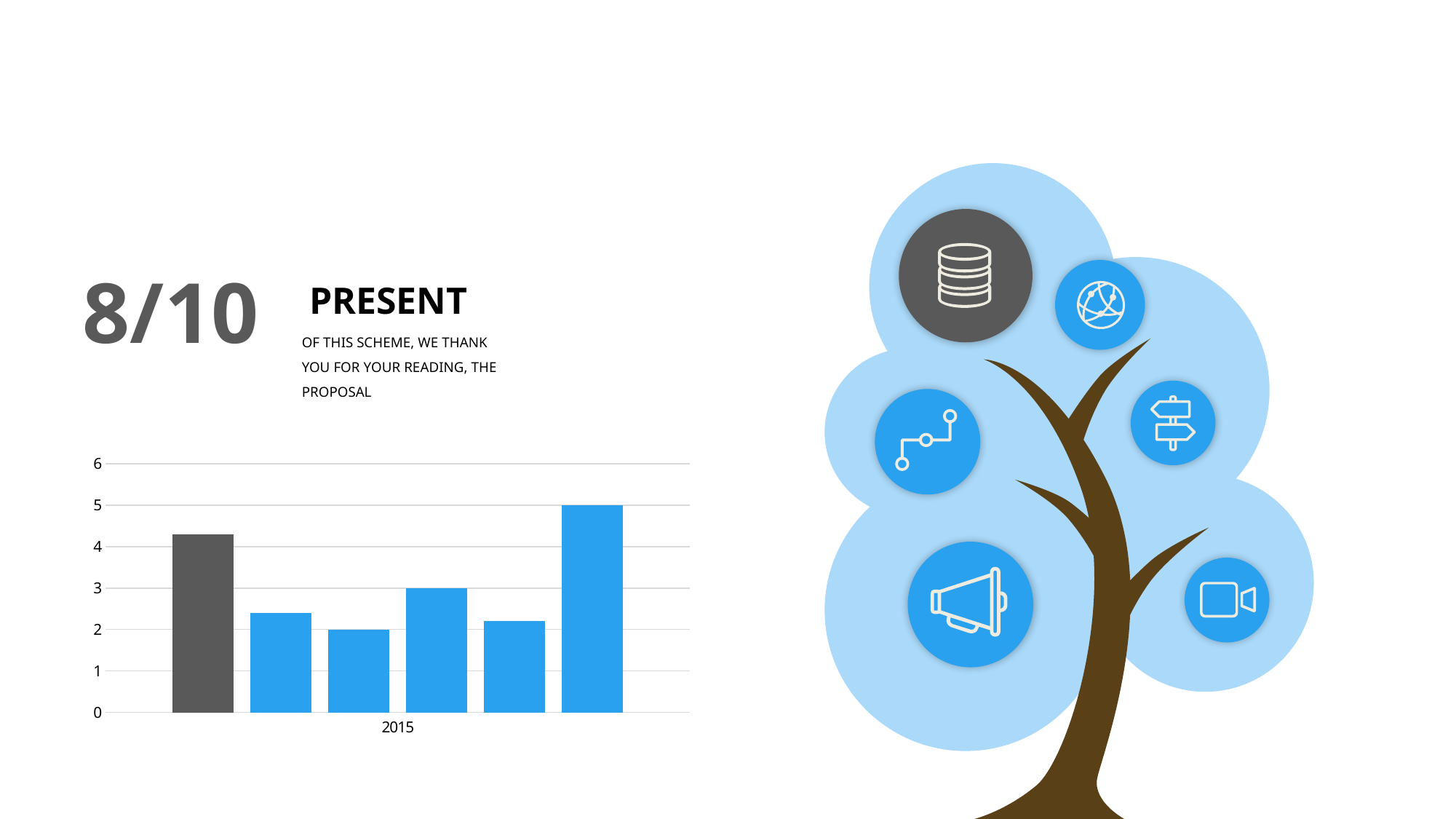
Which bar is the tallest in the chart? the rightmost (sixth) bar What kind of chart is shown on the slide? bar chart What is the value of the fourth bar from the left in the chart? 3 Is the value of the second bar from the left greater or less than 3? less What is the value of the rightmost bar in the chart? 5 What is the value of the third bar from the left in the chart? 2 Which is taller, the first bar or the rightmost bar? the rightmost bar What is the difference between the rightmost bar and the third bar from the left? 3 How many bars are plotted in the chart? 6 Is the value of the fifth bar from the left greater or less than 3? less Is the value of the first (gray) bar greater or less than 4? greater What label appears on the x axis of the chart? 2015